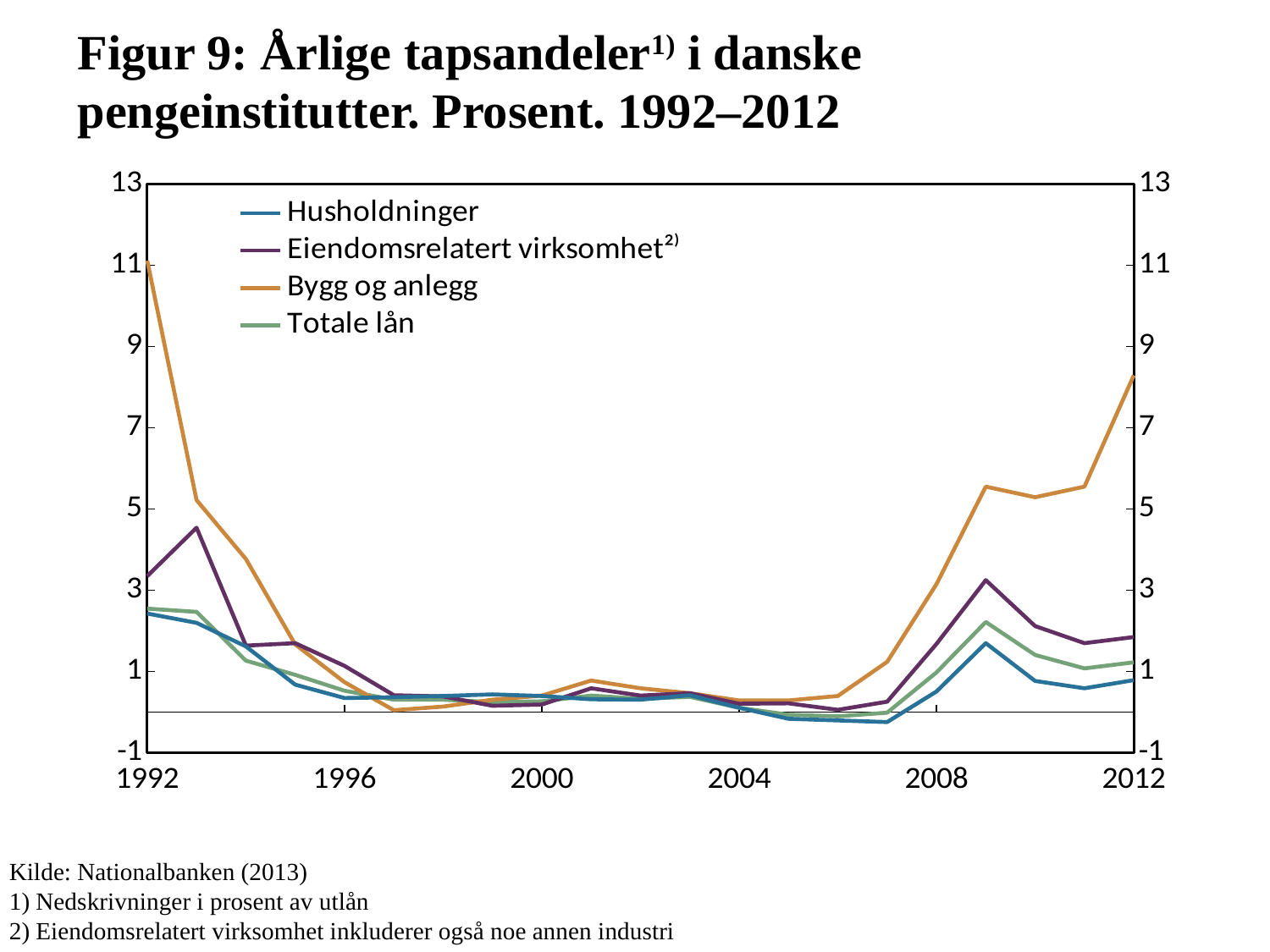
What unit does the chart title say the values are in? Prosent Which series is highest in 1992? Bygg og anlegg Is the value for Bygg og anlegg in 2012 greater or less than 7? greater What kind of chart is shown on the slide? line chart Which series is highest in 2012? Bygg og anlegg Does the Bygg og anlegg line rise or fall from 1992 to 1996? fall In 1992, which is larger: Bygg og anlegg or Eiendomsrelatert virksomhet? Bygg og anlegg Is the value for Eiendomsrelatert virksomhet in 1993 greater or less than 3? greater Is the value for Husholdninger in 2009 greater or less than 3? less How many series does the legend list? 4 Which series is lowest in 2009? Husholdninger